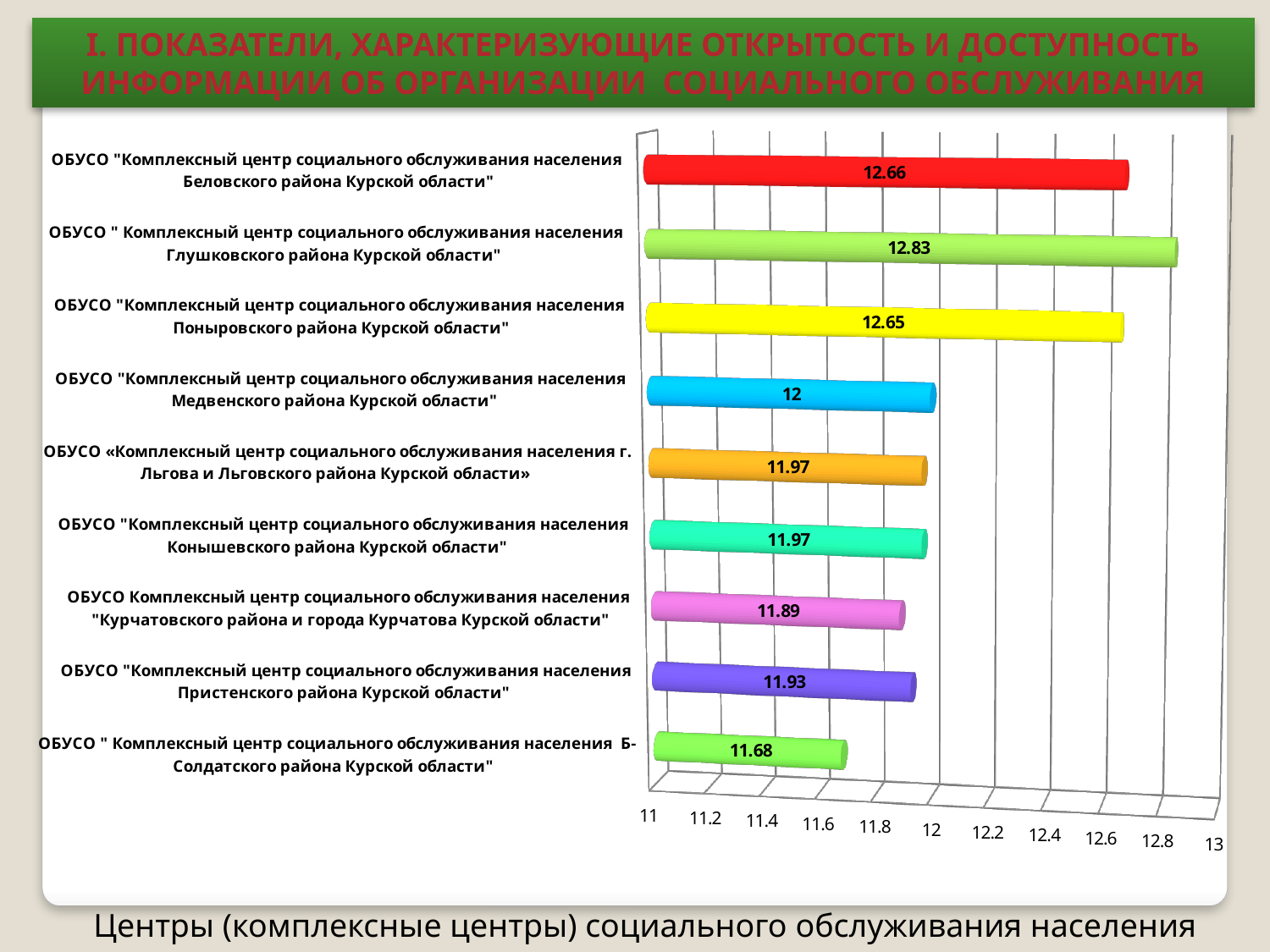
Which has a larger value: the Курчатовского района centre or the Пристенского района centre? ОБУСО "Комплексный центр социального обслуживания населения Пристенского района Курской области" Is the value for the Конышевского района centre greater or less than 12? less What colour is the bar for the Медвенского района centre? blue What is the value for ОБУСО "Комплексный центр социального обслуживания населения Пристенского района Курской области"? 11.93 Which centre has the lowest value on the chart? ОБУСО "Комплексный центр социального обслуживания населения Б-Солдатского района Курской области" Which centre has the highest value on the chart? ОБУСО "Комплексный центр социального обслуживания населения Глушковского района Курской области" What is the value for ОБУСО "Комплексный центр социального обслуживания населения Медвенского района Курской области"? 12 What is the value for ОБУСО "Комплексный центр социального обслуживания населения Беловского района Курской области"? 12.66 What is the difference between the values for the Беловского района centre and the Поныровского района centre? 0.01 How many centres are shown on the chart? 9 What is the difference between the values for the Глушковского района centre and the Б-Солдатского района centre? 1.15 What kind of chart is shown on the slide? bar chart